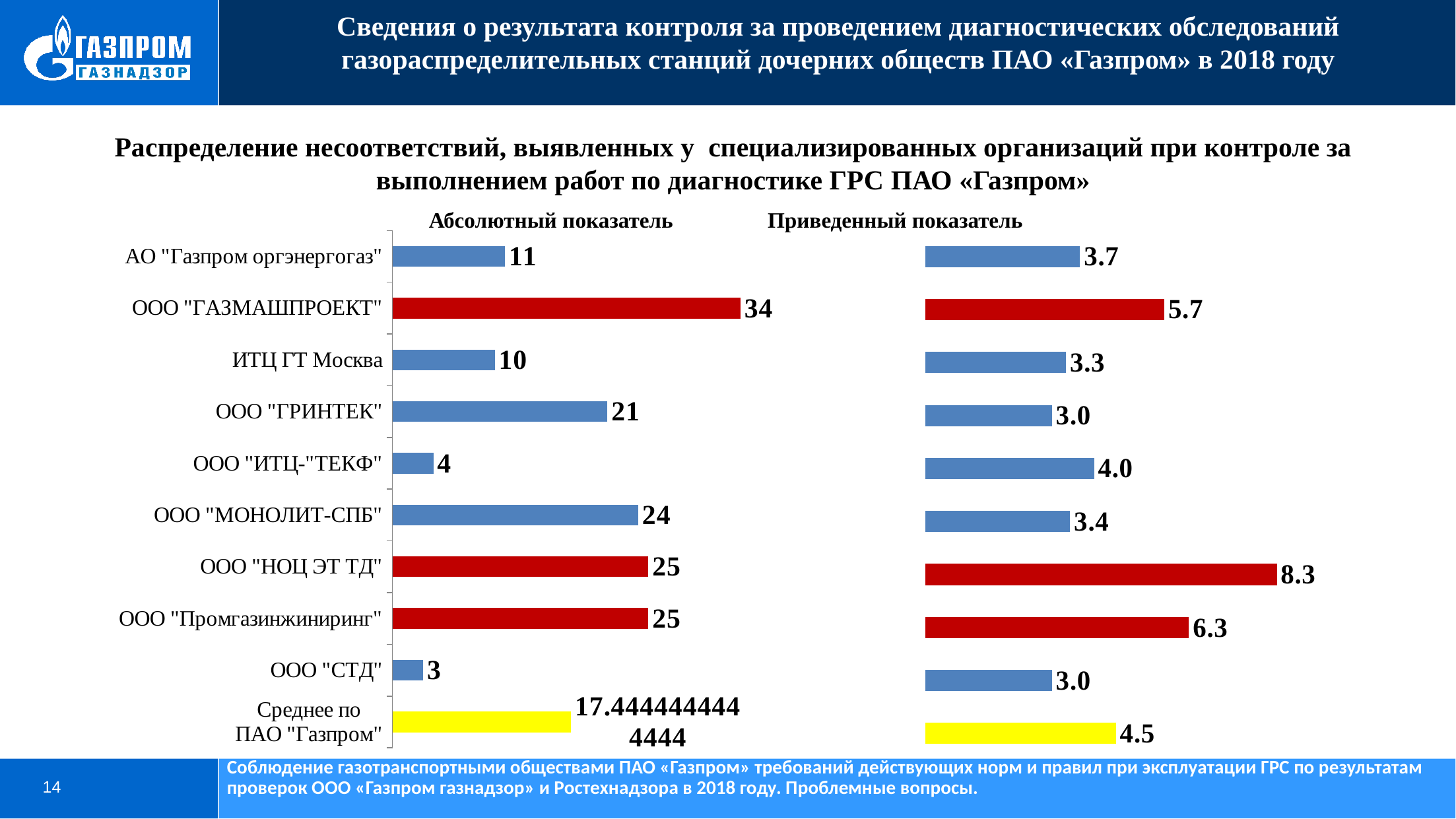
In the "Абсолютный показатель" chart, which organisation has the highest value? ООО "ГАЗМАШПРОЕКТ" In the "Абсолютный показатель" chart, which organisation has the lowest value? ООО "СТД" In the "Абсолютный показатель" chart, what is the value for ООО "ГАЗМАШПРОЕКТ"? 34 In the "Приведенный показатель" chart, what is the value for ООО "НОЦ ЭТ ТД"? 8.3 In the "Приведенный показатель" chart, which organisation has the highest value? ООО "НОЦ ЭТ ТД" In the "Абсолютный показатель" chart, what is the difference between ООО "ГАЗМАШПРОЕКТ" and ООО "МОНОЛИТ-СПБ"? 10 In the "Абсолютный показатель" chart, which is larger: ООО "ГРИНТЕК" or АО "Газпром оргэнергогаз"? ООО "ГРИНТЕК" What kind of chart is the "Приведенный показатель" chart? Bar chart In the "Приведенный показатель" chart, what is the value for Среднее по ПАО "Газпром"? 4.5 In the "Приведенный показатель" chart, which is larger: ООО "ИТЦ-"ТЕКФ" or ИТЦ ГТ Москва? ООО "ИТЦ-"ТЕКФ" How many categories (rows) are shown in the "Абсолютный показатель" chart? 10 In the "Приведенный показатель" chart, what is the difference between ООО "Промгазинжиниринг" and ООО "ГРИНТЕК"? 3.3